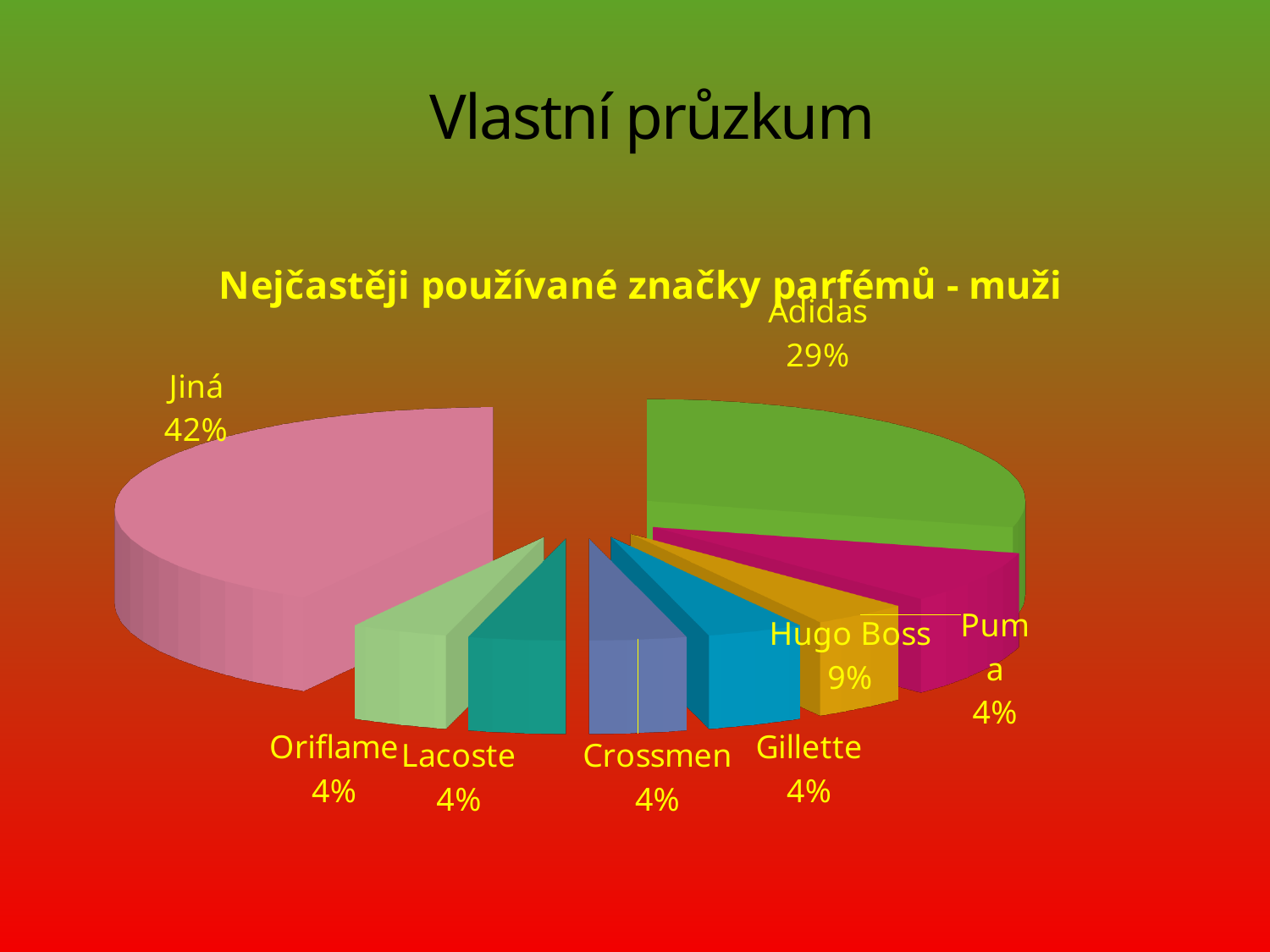
What is the title of the chart? Nejčastěji používané značky parfémů - muži What is the difference between the shares of Hugo Boss and Puma? 5% What kind of chart is shown on the slide? pie chart What share of the pie does Hugo Boss have? 9% What is the difference between the shares of Jiná and Adidas? 13% Which category has the largest slice of the pie? Jiná Which is larger, the share for Adidas or the share for Hugo Boss? Adidas What share of the pie does Lacoste have? 4% What share of the pie does Jiná have? 42% How many slices does the pie chart have? 8